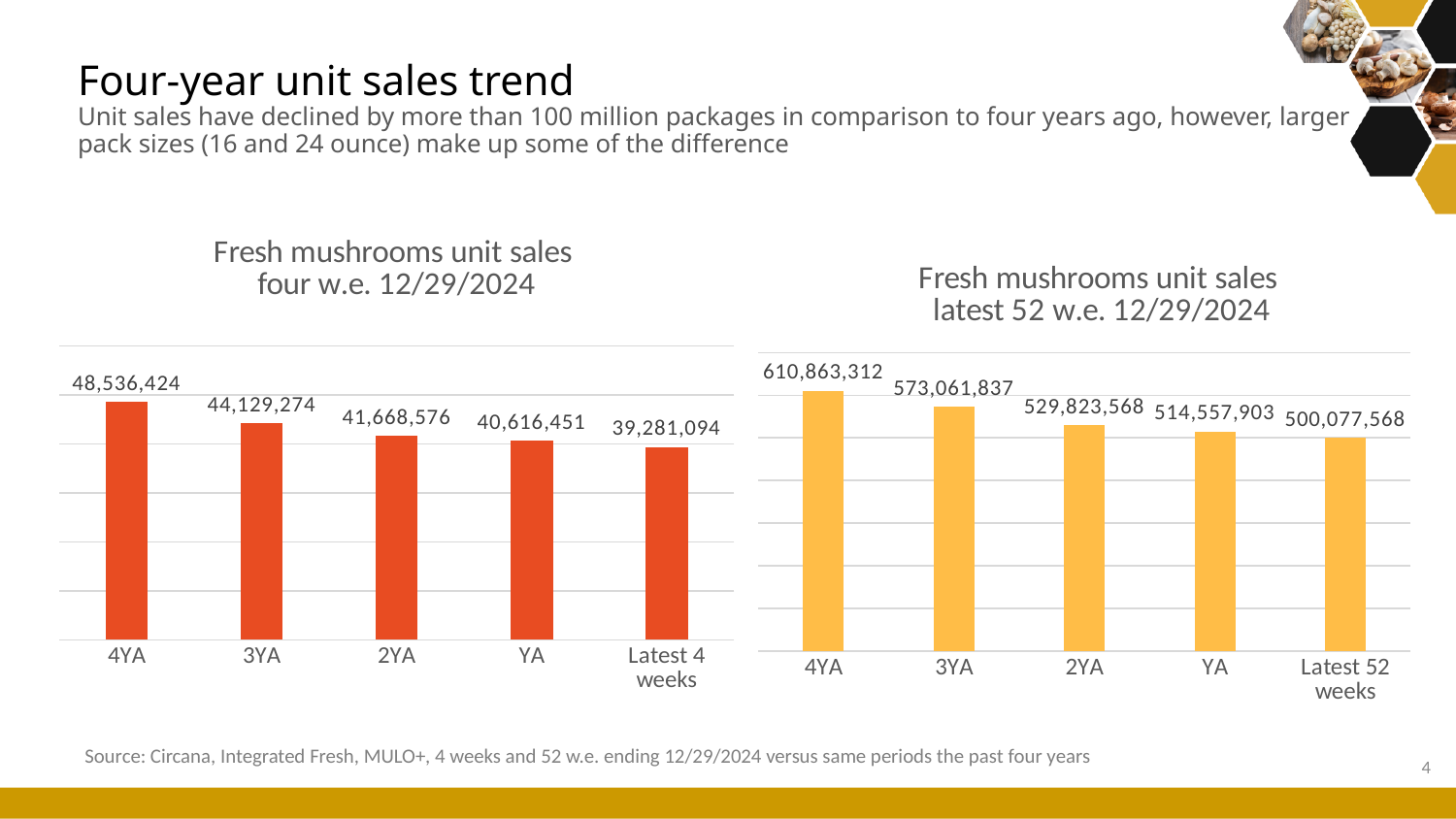
What kind of chart is the 'Fresh mushrooms unit sales four w.e. 12/29/2024' chart? Bar chart In the 'Fresh mushrooms unit sales four w.e. 12/29/2024' chart, which period has the lowest value? Latest 4 weeks How many periods are shown on the x axis of the 'Fresh mushrooms unit sales latest 52 w.e. 12/29/2024' chart? 5 In the 'Fresh mushrooms unit sales latest 52 w.e. 12/29/2024' chart, do the values rise or fall from 4YA to Latest 52 weeks? Fall In the 'Fresh mushrooms unit sales four w.e. 12/29/2024' chart, what is the value for 4YA? 48,536,424 In the 'Fresh mushrooms unit sales latest 52 w.e. 12/29/2024' chart, what is the value for 2YA? 529,823,568 In the 'Fresh mushrooms unit sales latest 52 w.e. 12/29/2024' chart, what is the value for YA? 514,557,903 In the 'Fresh mushrooms unit sales four w.e. 12/29/2024' chart, which is larger, the value for 3YA or the value for 2YA? 3YA In the 'Fresh mushrooms unit sales four w.e. 12/29/2024' chart, what is the value for Latest 4 weeks? 39,281,094 In the 'Fresh mushrooms unit sales latest 52 w.e. 12/29/2024' chart, what is the difference between the 4YA value and the Latest 52 weeks value? 110,785,744 In the 'Fresh mushrooms unit sales four w.e. 12/29/2024' chart, what is the difference between the 4YA value and the Latest 4 weeks value? 9,255,330 In the 'Fresh mushrooms unit sales latest 52 w.e. 12/29/2024' chart, which period has the highest value? 4YA